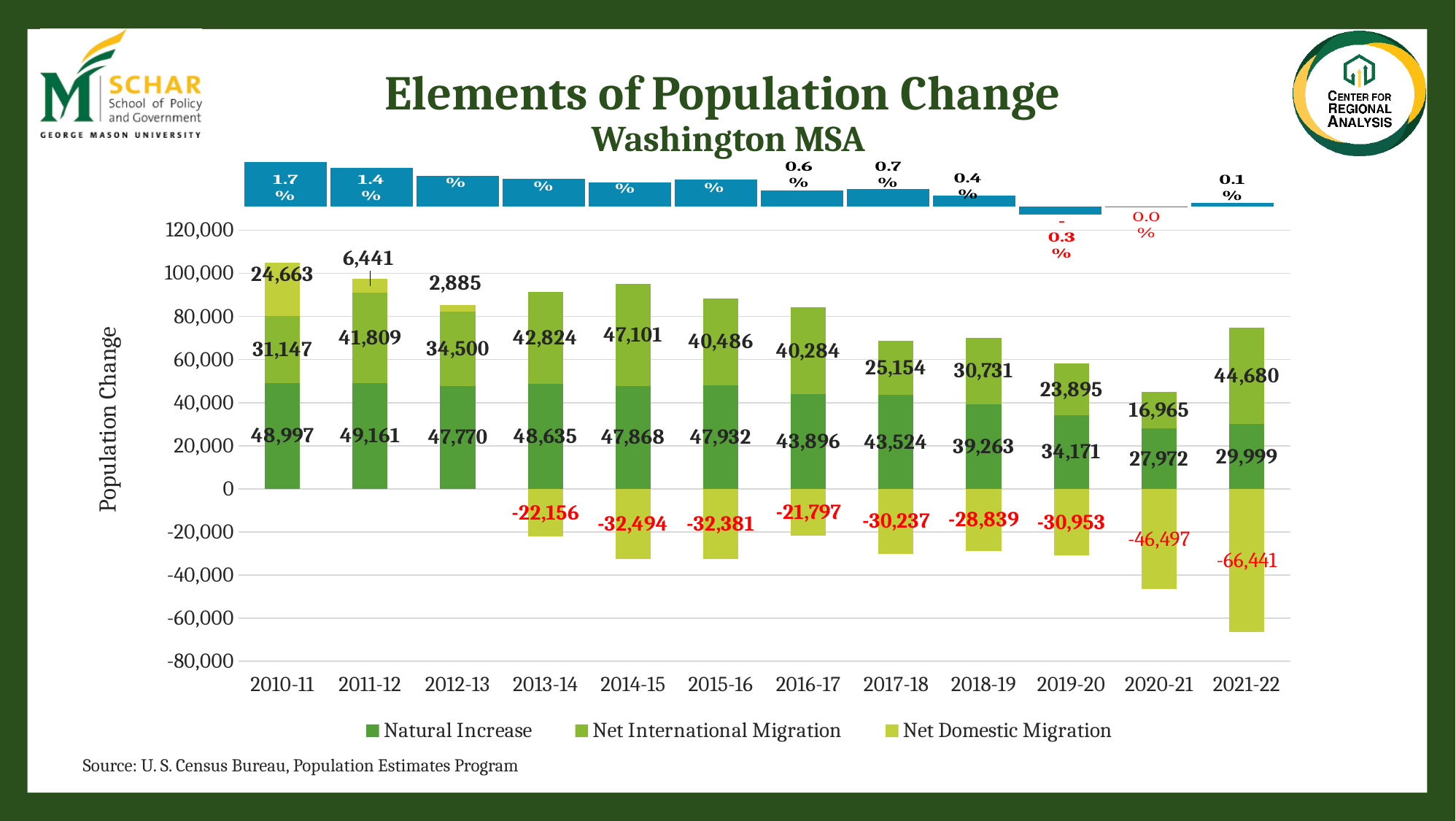
Which year has the larger Net International Migration, 2014-15 or 2021-22? 2014-15 How many years are shown on the x axis? 12 What is the Net Domestic Migration value for 2020-21? -46,497 What kind of chart is shown? Stacked bar chart In which year is Net Domestic Migration lowest? 2021-22 What is the Net International Migration value for 2017-18? 25,154 In which year is Natural Increase lowest? 2020-21 What is the Natural Increase value for 2015-16? 47,932 What is the difference between Natural Increase in 2010-11 and in 2021-22? 18,998 How many series does the legend list? 3 What is the total of the three components for 2010-11? 104,807 In which year is Net International Migration highest? 2014-15